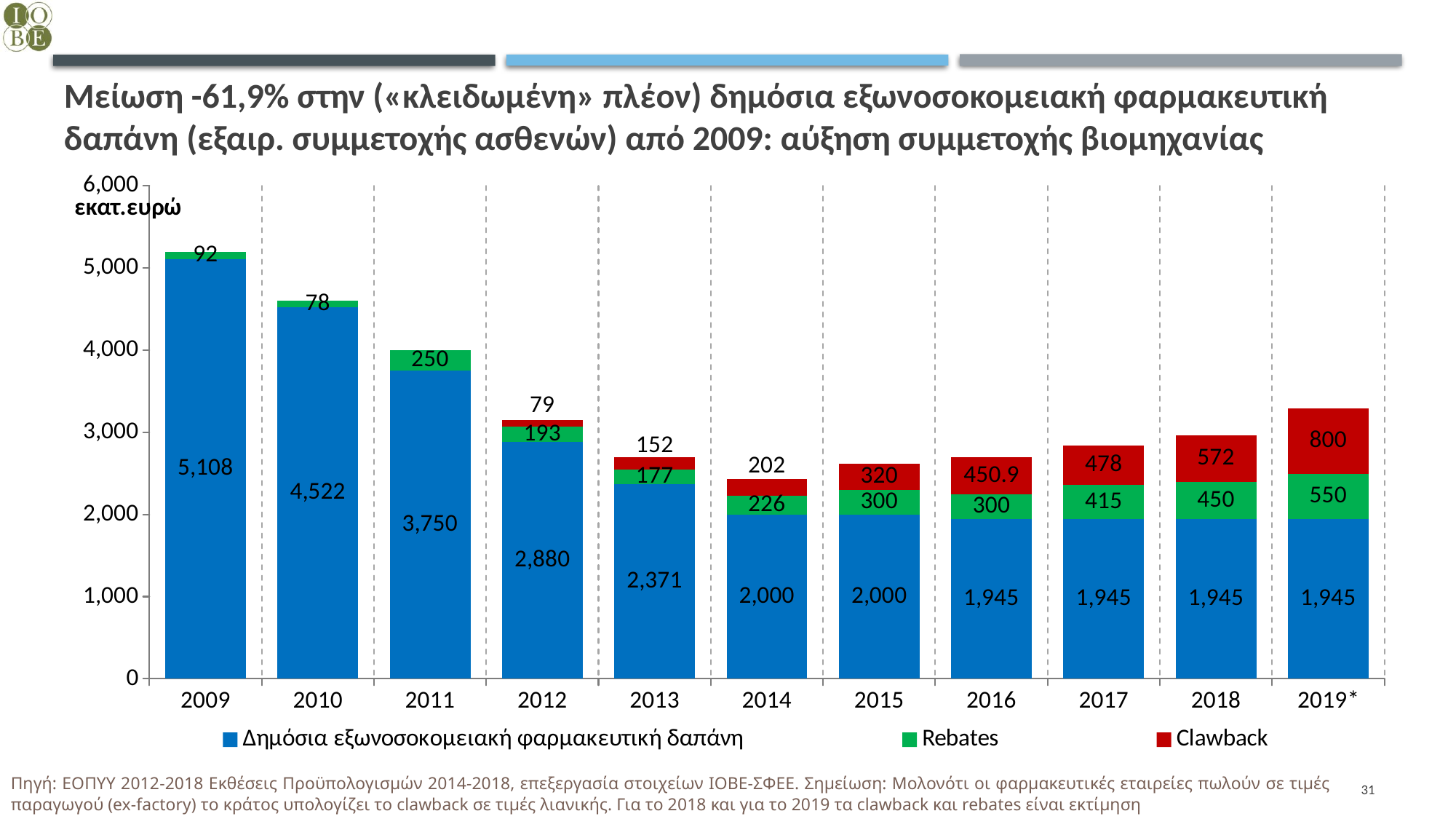
What is the value of Δημόσια εξωνοσοκομειακή φαρμακευτική δαπάνη for 2009? 5,108 Is the total stacked bar for 2011 greater or less than 3,000? greater What is the Rebates value for 2011? 250 Which year has the highest Clawback value? 2019* How many series does the legend list? 3 Which is larger in 2015, Rebates or Clawback? Clawback How many years are shown on the x axis? 11 What is the difference between the Clawback values for 2019* and 2018? 228 What kind of chart is shown on the slide? Stacked bar chart What is the Clawback value for 2016? 450.9 What is the total of the stacked bar for 2012? 3,152 Which year has the lowest Rebates value? 2010